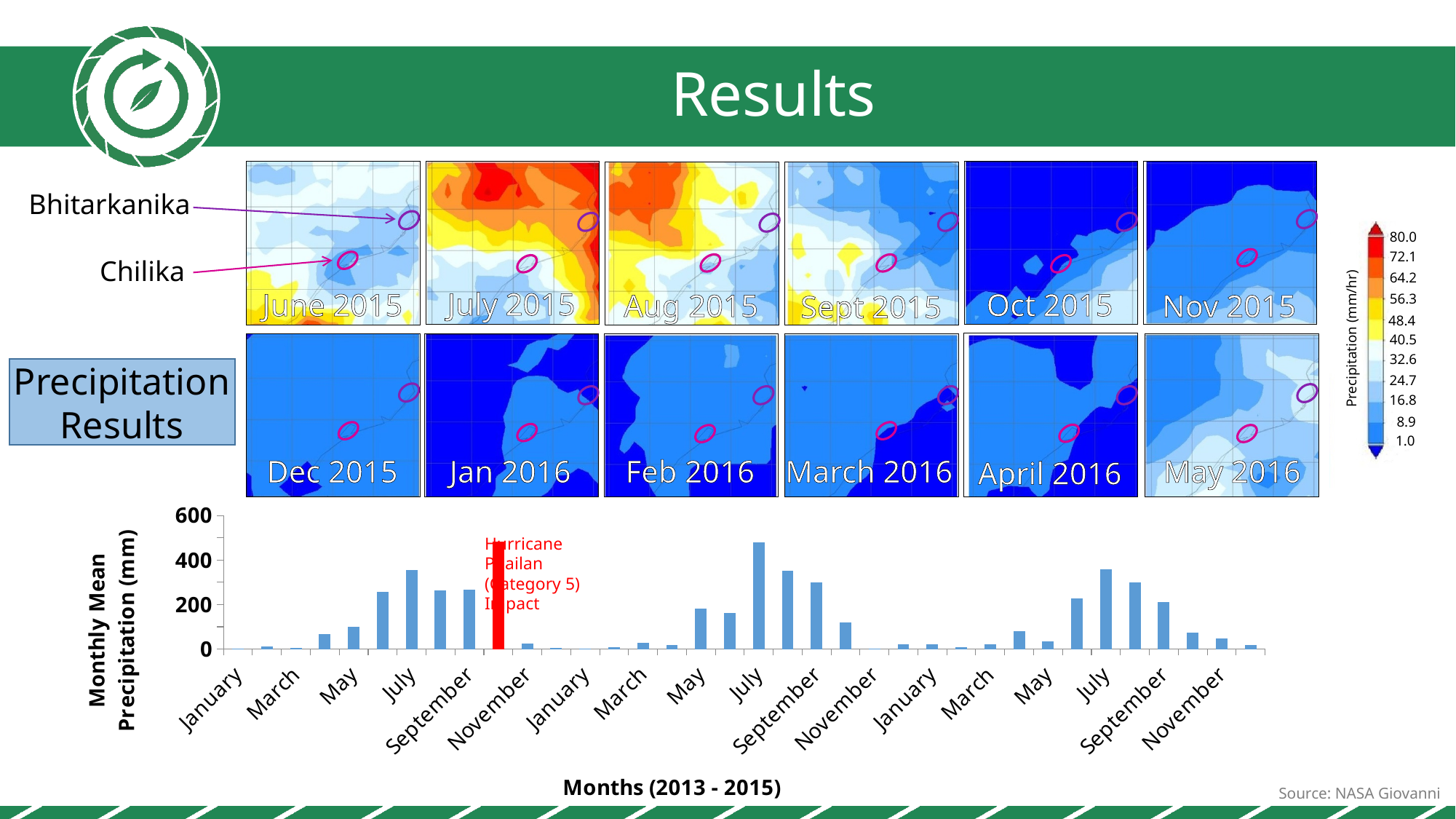
What event does the red bar in the bar chart mark? Hurricane Phailin (Category 5) Impact Is the value of the red bar (Hurricane Phailin) greater or less than 400? greater What kind of chart is shown at the bottom of the slide? Bar chart How many yearly cycles of months (January through November labels) does the bar chart's x axis show? 3 Is the value for July in the third year greater or less than 200? greater Is the value for July in the first year greater or less than 200? greater Which is larger: the May bar in the first year or the May bar in the third year? May in the first year Do the bars rise or fall from January to July in the first year? rise What is the title of the x axis of the bar chart? Months (2013 - 2015) Which is larger: the July bar in the first year or the July bar in the second year? July in the second year